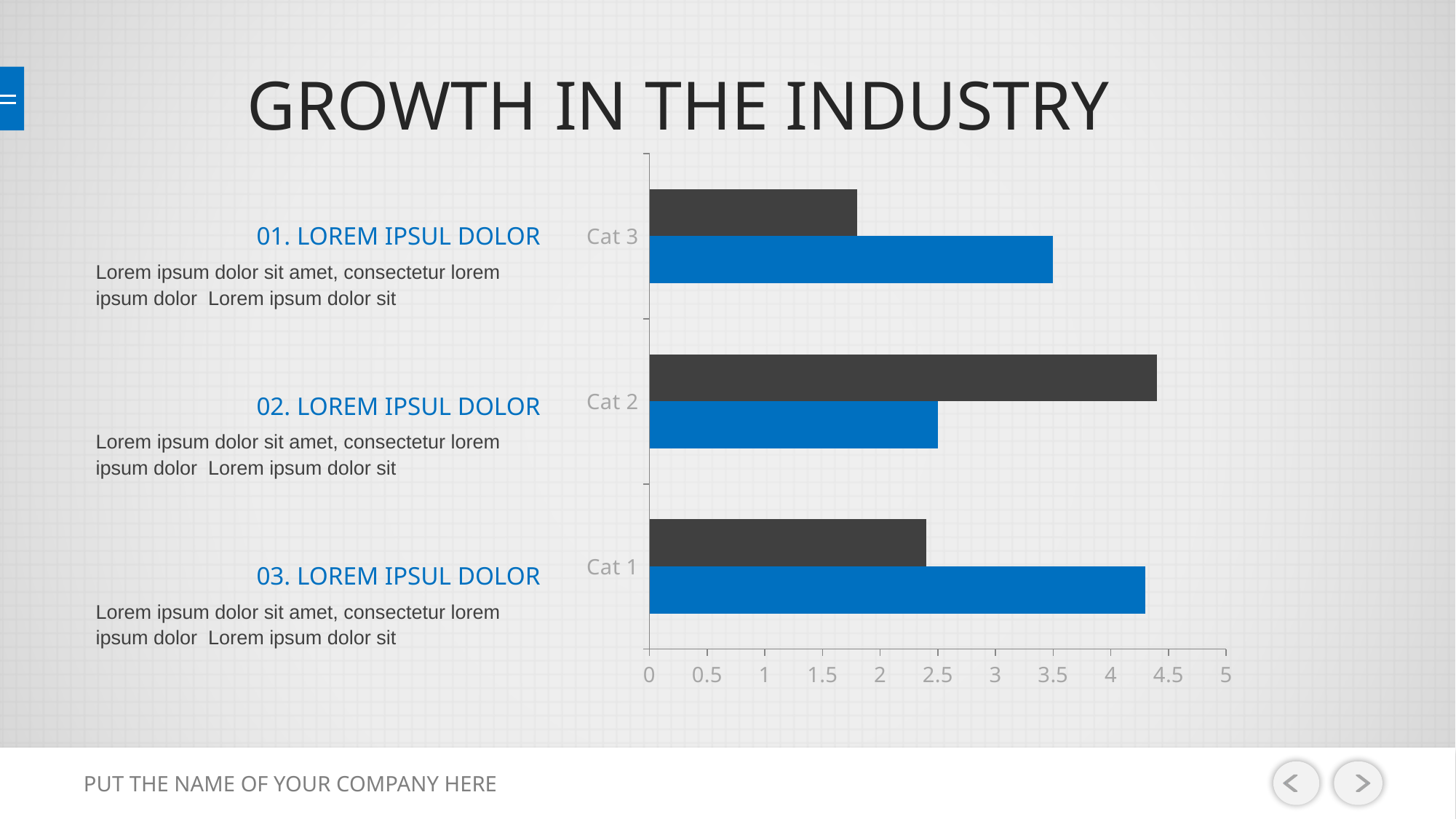
Which category has the shortest blue bar? Cat 2 What is the value of the blue bar for Cat 3? 3.5 How many categories are shown on the chart? 3 How many data series are plotted for each category? 2 Is the value of the dark gray bar for Cat 2 greater or less than 4? greater Which category has the longest dark gray bar? Cat 2 Is the value of the dark gray bar for Cat 3 greater or less than 2? less What is the value of the blue bar for Cat 2? 2.5 What is the title of the chart on the slide? GROWTH IN THE INDUSTRY For Cat 2, which bar is longer, the dark gray bar or the blue bar? the dark gray bar Is the value of the blue bar for Cat 1 greater or less than 4? greater What kind of chart is shown on the slide? bar chart